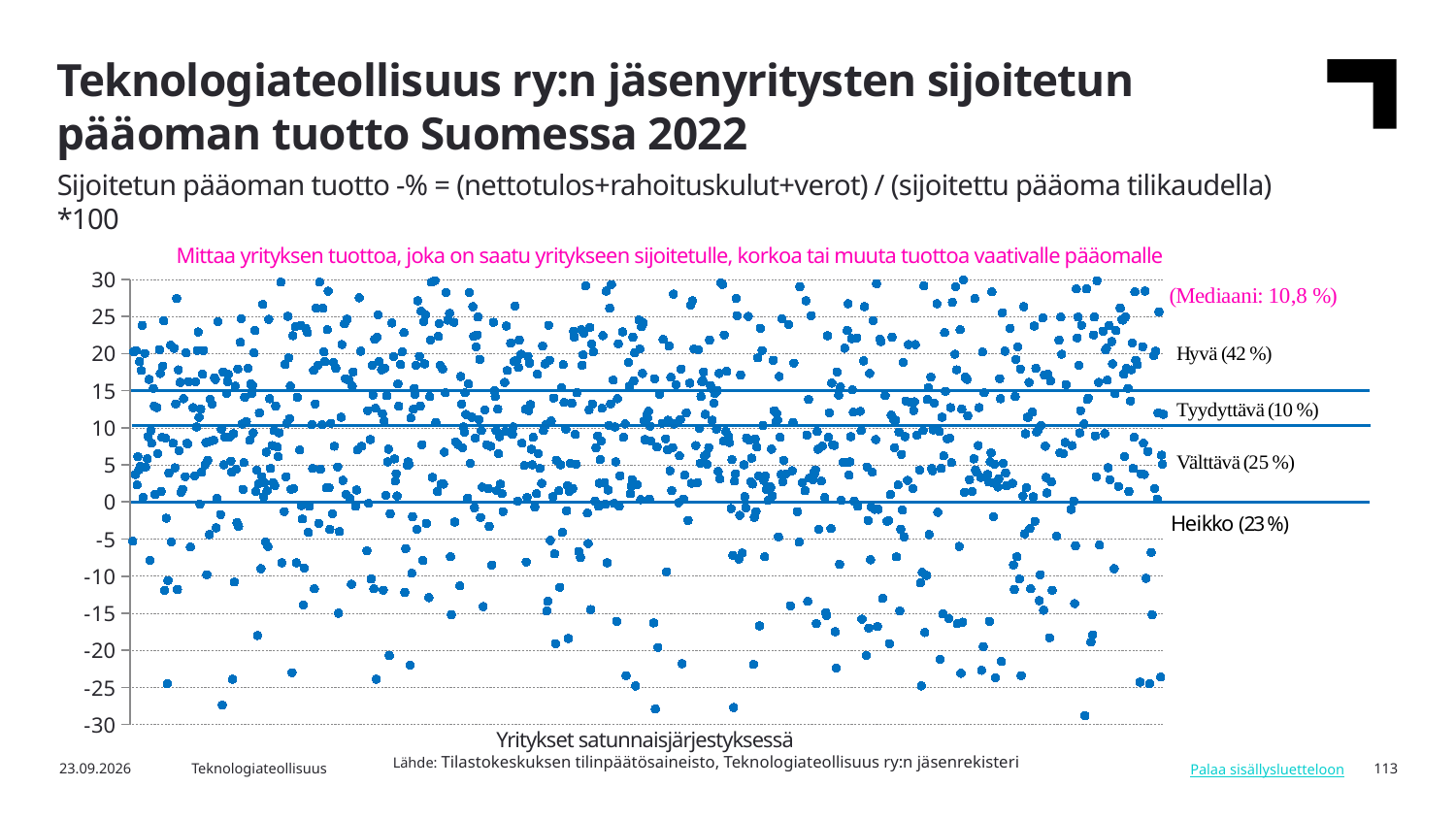
Which category has the smallest share of companies? Tyydyttävä What percentage of companies fall into the Heikko category? 23 % Which category has a larger share of companies, Välttävä or Heikko? Välttävä What percentage of companies fall into the Hyvä category? 42 % What is the median (Mediaani) value shown on the chart? 10,8 % Which category has the largest share of companies? Hyvä What kind of chart is shown on the slide? scatter chart What is the difference in percentage points between the Hyvä share and the Heikko share? 19 What percentage of companies fall into the Välttävä category? 25 % How many categories are labelled on the right side of the chart (excluding the median)? 4 What is the label of the x axis? Yritykset satunnaisjärjestyksessä What percentage of companies fall into the Tyydyttävä category? 10 %